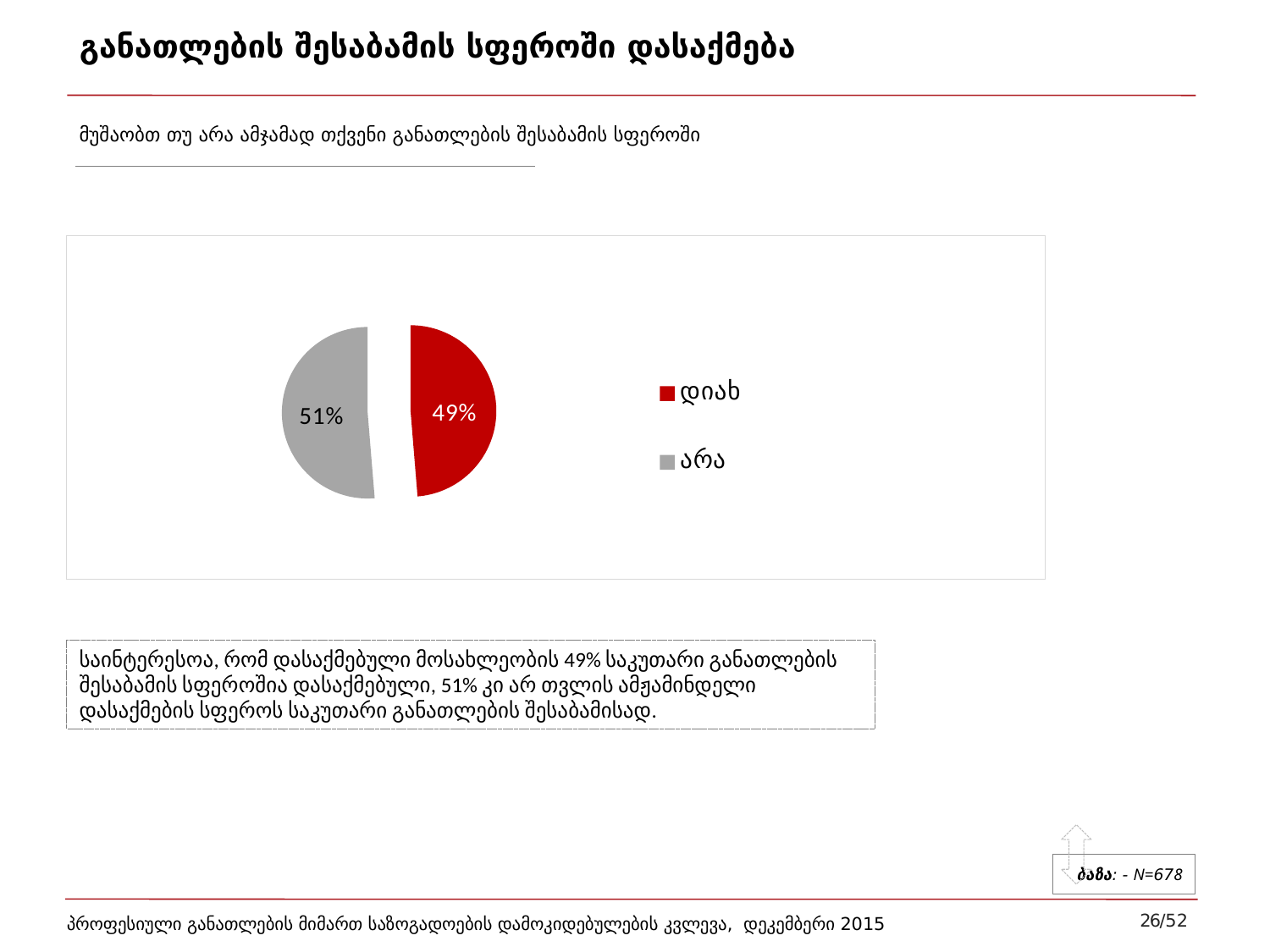
What colour is the "დიახ" slice in the pie chart? red What share of the pie does the "არა" slice represent? 51% What colour is the "არა" slice in the pie chart? grey What is the difference in percentage points between the "არა" and "დიახ" slices? 2 percentage points How many entries does the legend list? 2 Which is larger, the "დიახ" slice or the "არა" slice? არა How many slices does the pie chart have? 2 Is the value for "დიახ" greater or less than 50%? less Which slice of the pie is the largest? არა What kind of chart is shown on the slide? pie chart Which slice of the pie is the smallest? დიახ What share of the pie does the "დიახ" slice represent? 49%